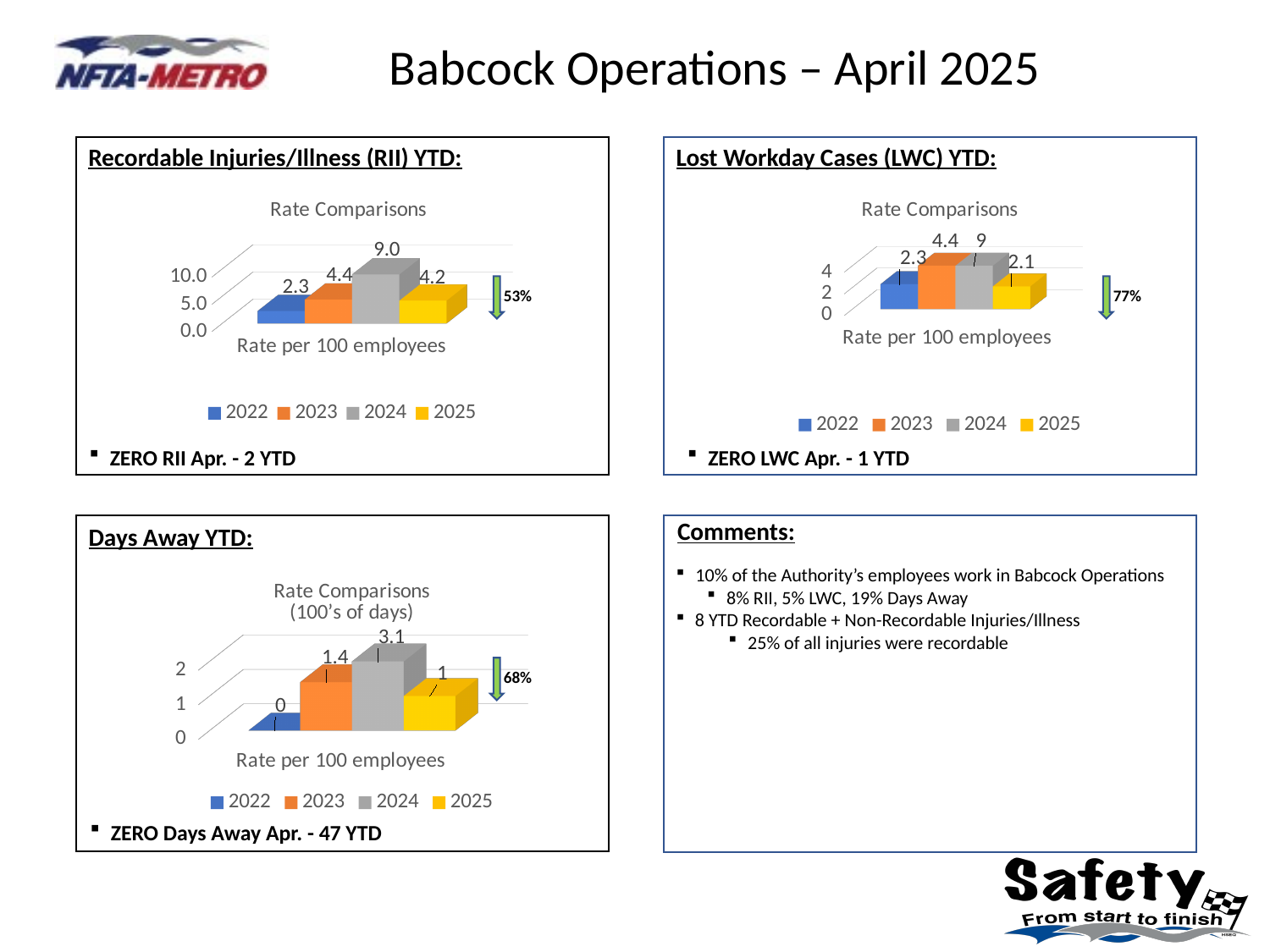
What kind of chart is the Recordable Injuries/Illness (RII) YTD chart? Bar chart In the Days Away YTD chart, what is the value for 2022? 0 In the Days Away YTD chart, what is the difference between the 2024 and 2023 values? 1.7 In the Recordable Injuries/Illness (RII) YTD chart, which year has the lowest value? 2022 In the Days Away YTD chart, what is the value for 2023? 1.4 In the Lost Workday Cases (LWC) YTD chart, is the value for 2023 larger or smaller than the value for 2025? larger In the Lost Workday Cases (LWC) YTD chart, what is the value for 2025? 2.1 What is the title of the chart in the Lost Workday Cases (LWC) YTD box? Rate Comparisons In the Recordable Injuries/Illness (RII) YTD chart, what is the value for 2024? 9.0 In the Recordable Injuries/Illness (RII) YTD chart, what is the difference between the 2024 and 2025 values? 4.8 In the Lost Workday Cases (LWC) YTD chart, which year has the highest value? 2024 How many series does the legend of the Days Away YTD chart list? 4